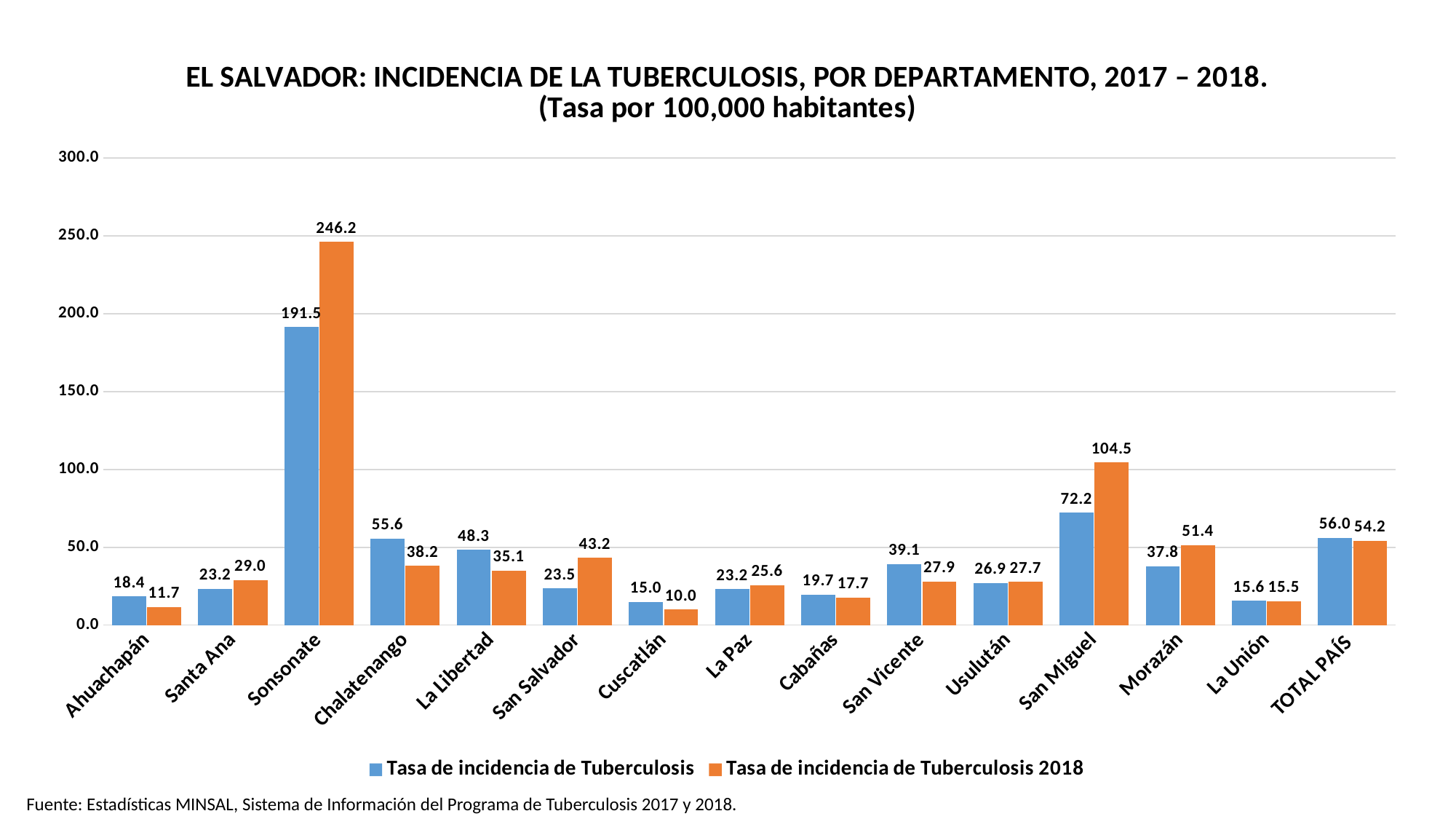
What is the difference between the blue-series and 2018 incidence rates for Chalatenango? 17.4 What is the 2018 tuberculosis incidence rate for Sonsonate? 246.2 What kind of chart is shown on the slide? Bar chart Which is larger for San Salvador: the blue-series rate or the 2018 rate? 2018 rate (43.2) What is the difference between the 2018 and the blue-series incidence rates for Sonsonate? 54.7 Which department has the lowest 2018 tuberculosis incidence rate? Cuscatlán What is the 2018 incidence rate for TOTAL PAÍS? 54.2 Which department has the highest 2018 tuberculosis incidence rate? Sonsonate How many categories are shown on the x axis? 15 How many series does the legend list? 2 Is the 2018 incidence rate for San Miguel greater or less than 100? greater What is the value of the 'Tasa de incidencia de Tuberculosis' (blue) series for San Miguel? 72.2